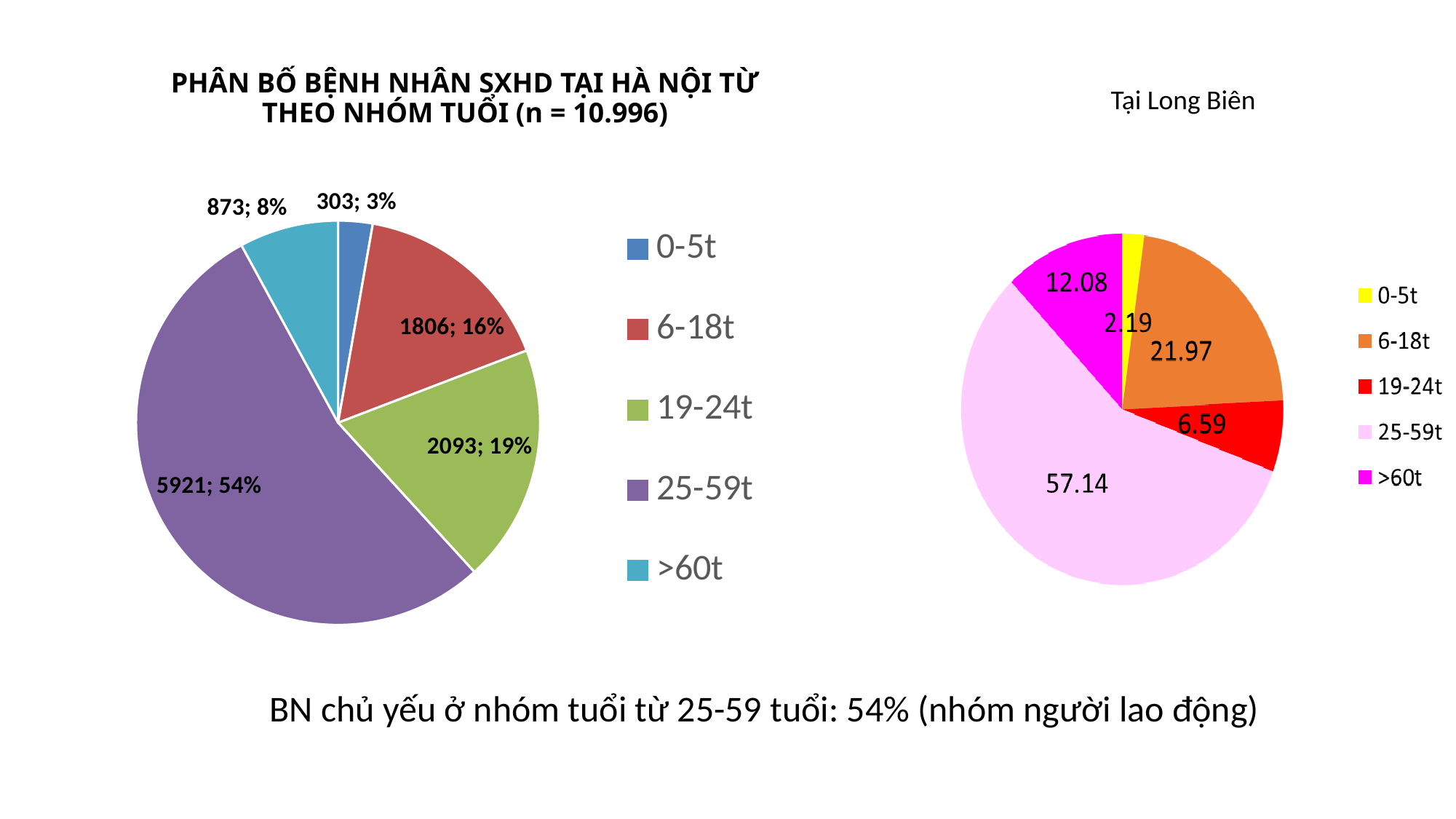
In the right pie chart (Tại Long Biên), what is the value for the 25-59t slice? 57.14 In the left pie chart (Hà Nội), what is the data label for the 25-59t slice? 5921; 54% In the left pie chart (Hà Nội), how many patients are in the 6-18t group? 1806 What type of chart is used on the left side of the slide (Hà Nội)? Pie chart In the left pie chart (Hà Nội), what percentage share does the >60t slice have? 8% In the left pie chart (Hà Nội), which age group has the smallest slice? 0-5t In the right pie chart (Tại Long Biên), which is larger, the 6-18t slice or the 19-24t slice? 6-18t In the left pie chart (Hà Nội), what is the difference in patient count between the 19-24t and 6-18t groups? 287 In the right pie chart (Tại Long Biên), which age group has the smallest slice? 0-5t In the left pie chart (Hà Nội), which age group has the largest slice? 25-59t In the right pie chart (Tại Long Biên), what is the value for the >60t slice? 12.08 How many age groups does the legend of the right pie chart (Tại Long Biên) list? 5